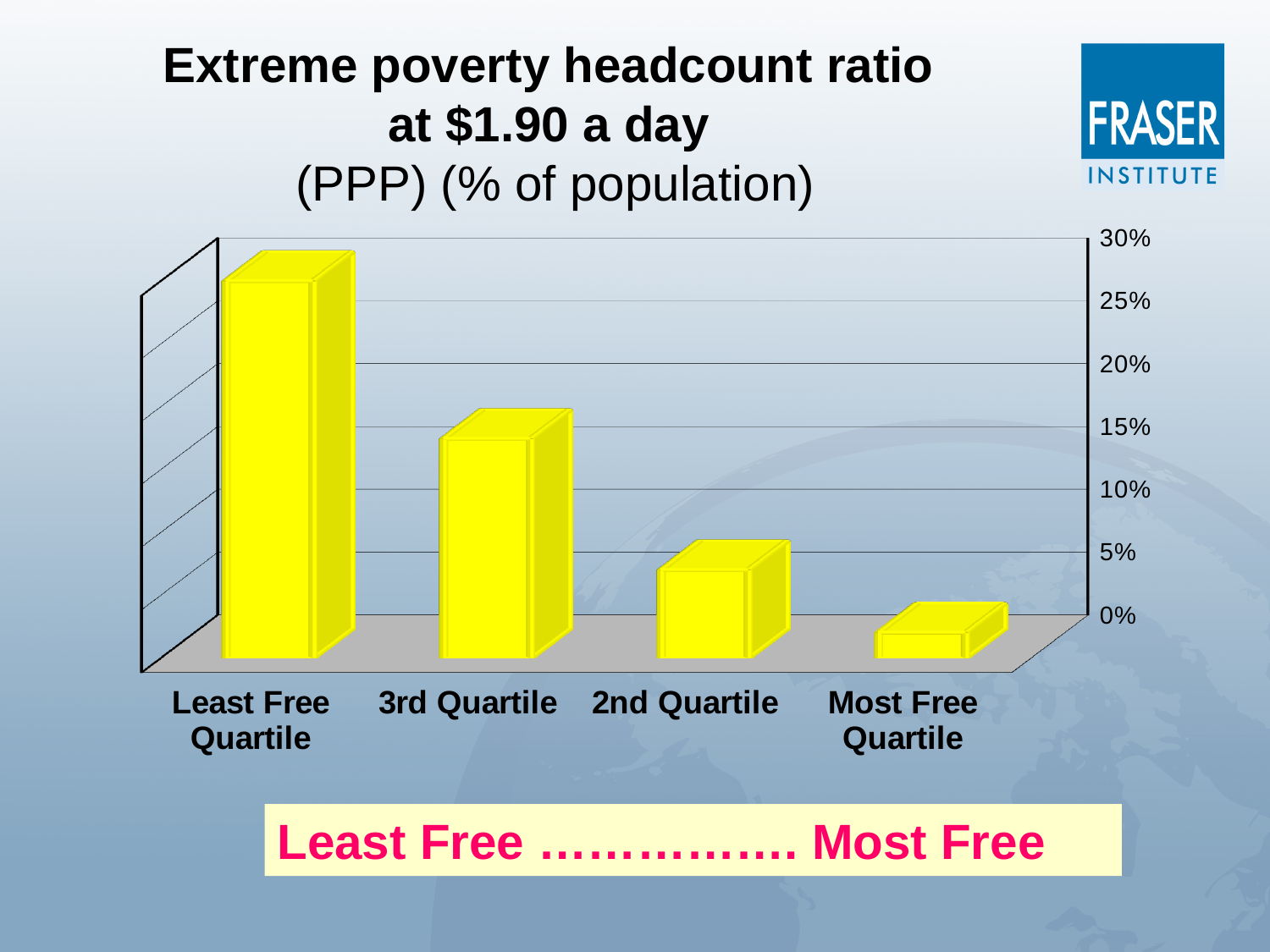
Which is larger, the value for the 3rd Quartile or the value for the 2nd Quartile? 3rd Quartile What colour are the bars in the chart? yellow Do the values rise or fall moving from the Least Free Quartile to the Most Free Quartile? fall Which quartile has the highest extreme poverty headcount ratio? Least Free Quartile How many categories are plotted on the chart? 4 Is the value for the Most Free Quartile greater or less than 5%? less What kind of chart is shown on the slide? bar chart Is the value for the Least Free Quartile greater or less than 25%? greater Is the value for the 3rd Quartile greater or less than 10%? greater What is the highest value shown on the vertical axis? 30% Which quartile has the lowest extreme poverty headcount ratio? Most Free Quartile